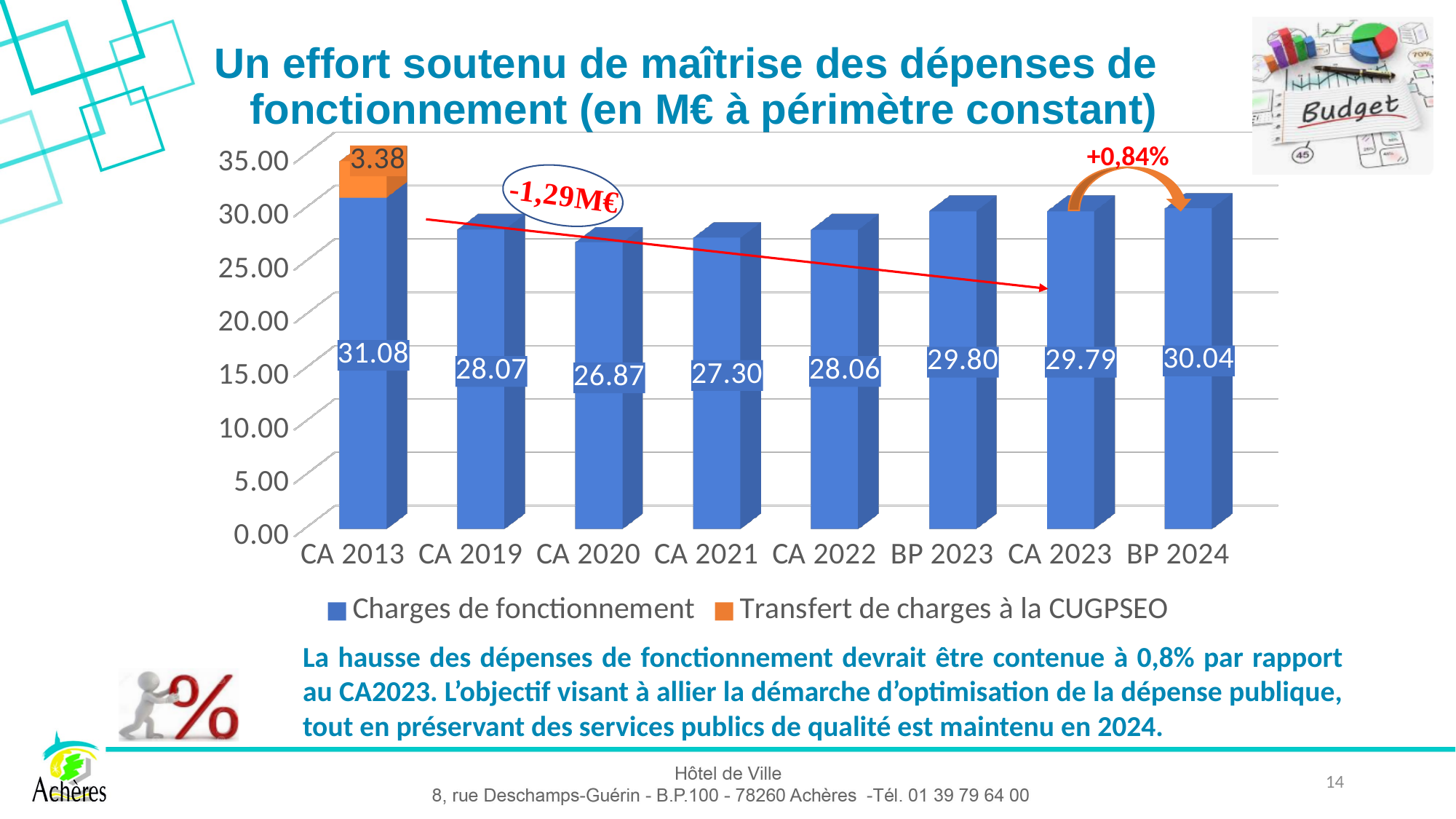
Which category has the lowest value for Charges de fonctionnement? CA 2020 What is the value of Charges de fonctionnement for CA 2020? 26.87 What is the value of Transfert de charges à la CUGPSEO for CA 2013? 3.38 How many series does the legend list? 2 What is the difference between the Charges de fonctionnement values for BP 2024 and CA 2023? 0.25 Which is larger, the Charges de fonctionnement value for CA 2021 or for CA 2022? CA 2022 What is the total of the stacked bar for CA 2013? 34.46 What kind of chart is shown on the slide? Bar chart Which series is shown in orange in the legend? Transfert de charges à la CUGPSEO How many categories are shown on the x axis? 8 Which category has the highest value for Charges de fonctionnement? CA 2013 What is the value of Charges de fonctionnement for BP 2024? 30.04